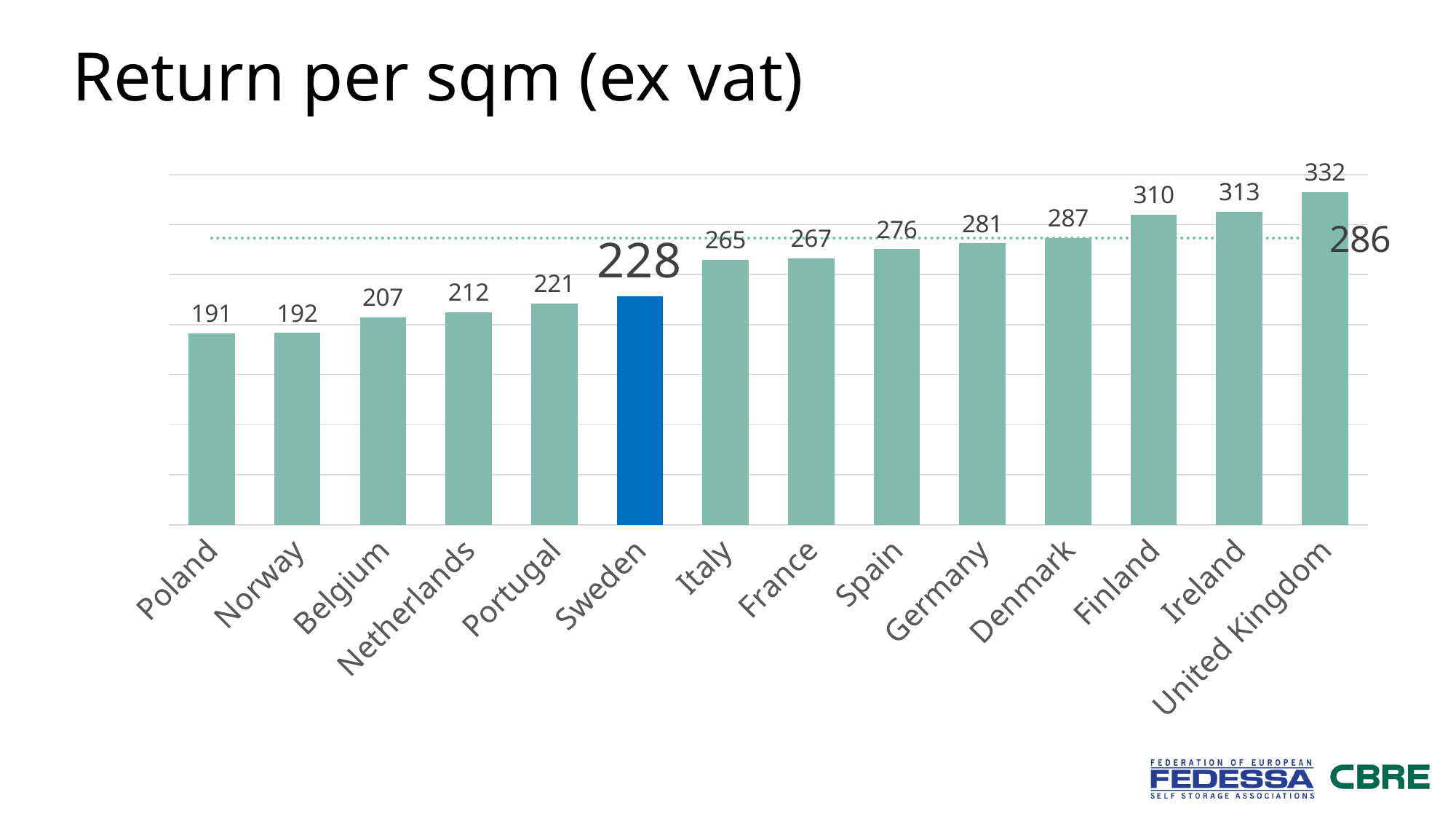
How many countries are shown in the chart? 14 What is the return per sqm for Sweden? 228 What is the return per sqm for Germany? 281 What is the difference between the return per sqm for Ireland and Finland? 3 What value is marked by the dotted horizontal line on the chart? 286 Do the values rise or fall from left to right across the countries? Rise Which has a higher return per sqm, Italy or Denmark? Denmark Which country has the highest return per sqm? United Kingdom What kind of chart is shown on the slide? Bar chart What is the difference between the return per sqm for the United Kingdom and Sweden? 104 Which country has the lowest return per sqm? Poland What is the return per sqm for Poland? 191